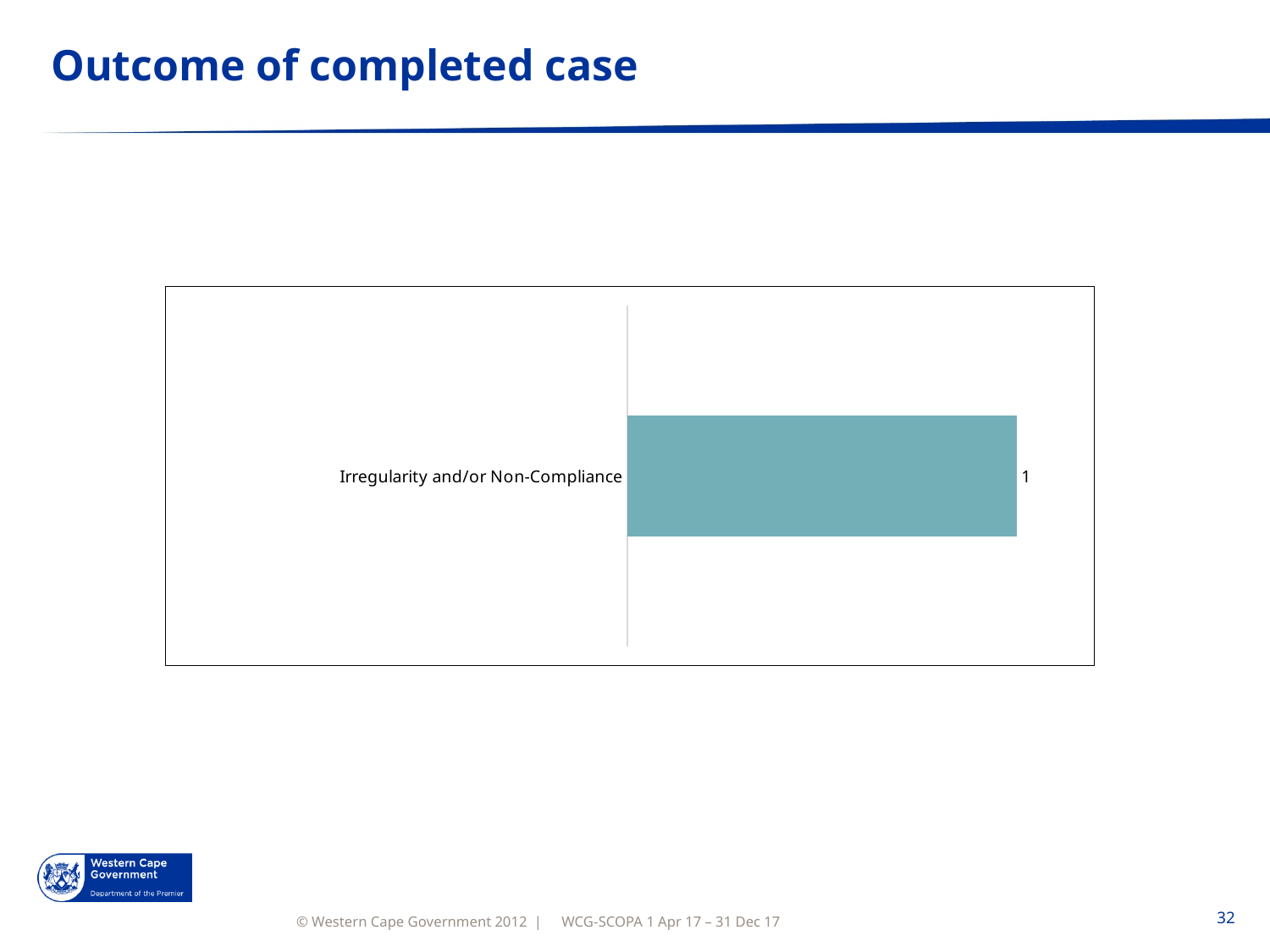
What is the label of the only category shown in the chart? Irregularity and/or Non-Compliance What kind of chart is shown on the slide? bar chart Are the bars in the chart horizontal or vertical? horizontal What is the title of the slide containing the chart? Outcome of completed case What is the value for Irregularity and/or Non-Compliance? 1 How many categories are plotted in the chart? 1